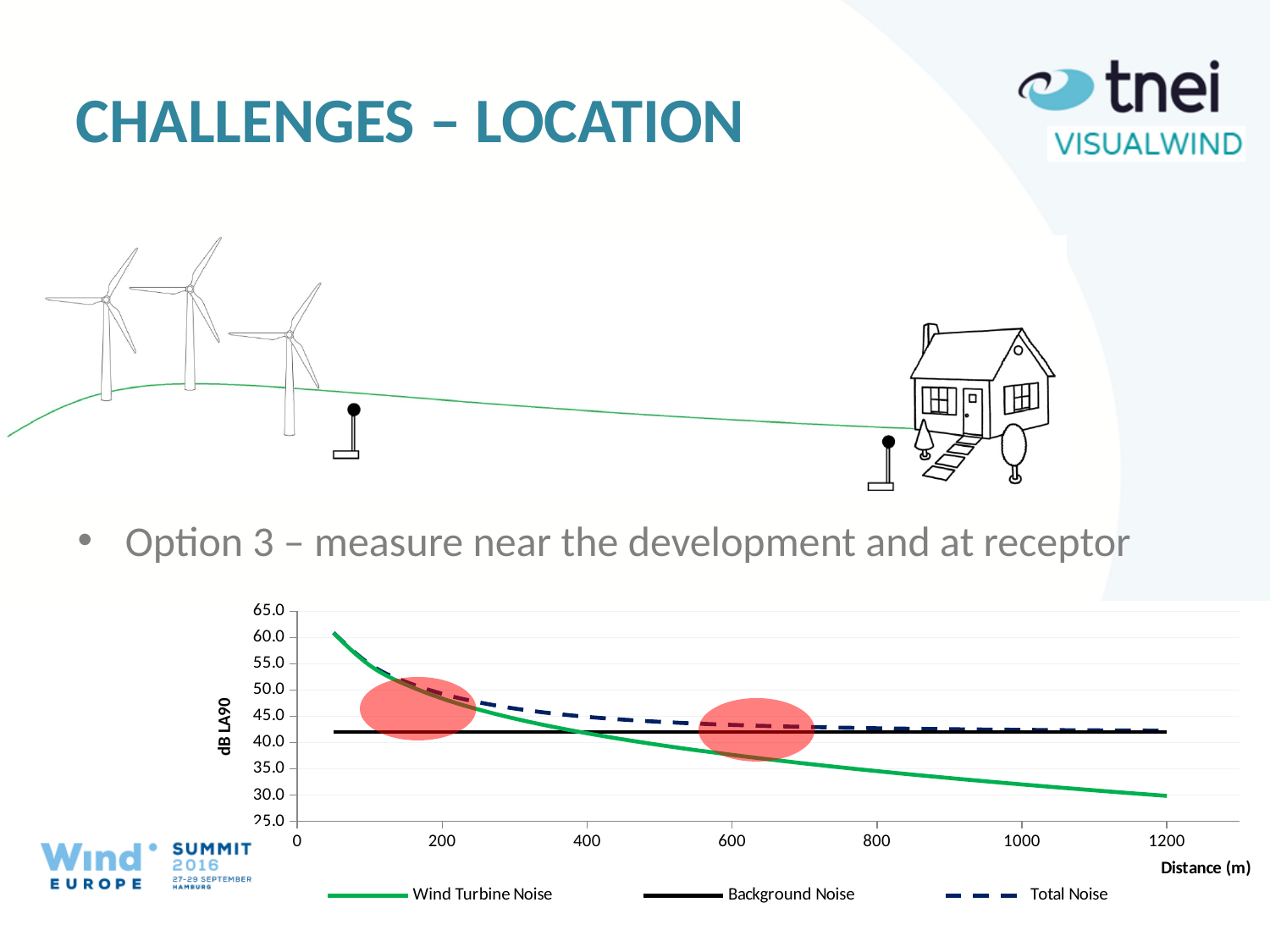
What kind of chart is shown on the slide? line chart At 100 m, which is higher: Wind Turbine Noise or Background Noise? Wind Turbine Noise What are the three series named in the chart's legend? Wind Turbine Noise, Background Noise, Total Noise Does the Wind Turbine Noise line rise or fall as distance increases? fall How many series does the chart's legend list? 3 Does the Background Noise line rise, fall or stay flat as distance increases? stay flat What is the label of the chart's x axis? Distance (m) Is the Wind Turbine Noise value at 1200 m greater or less than 35.0? less At 1000 m, which is higher: Total Noise or Wind Turbine Noise? Total Noise Is the Total Noise value at 1200 m greater or less than 40.0? greater Is the Background Noise value greater or less than 40.0? greater